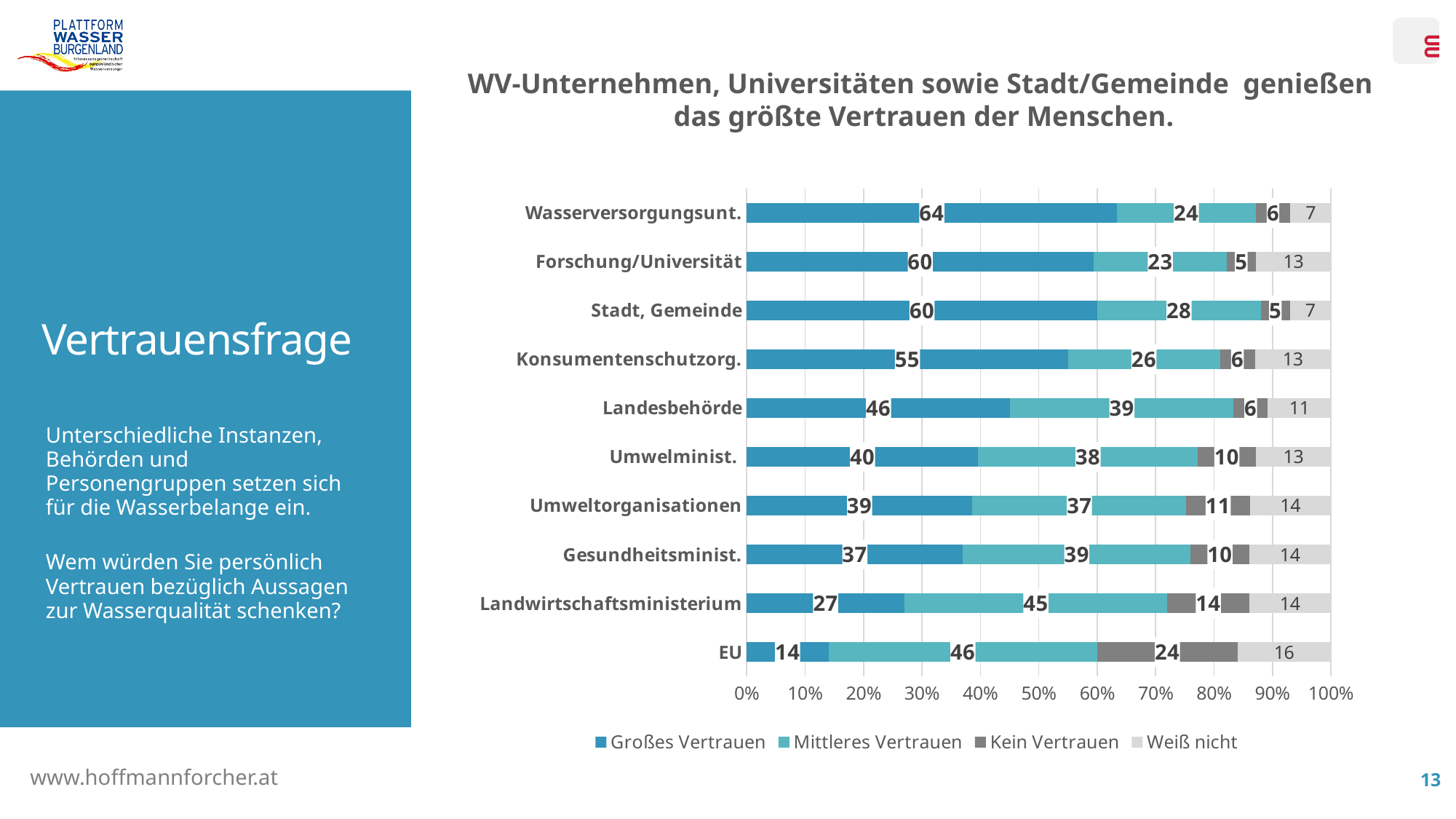
What is the value of 'Mittleres Vertrauen' for Landwirtschaftsministerium? 45 Which category has the highest value for 'Großes Vertrauen'? Wasserversorgungsunt. What is the value of 'Großes Vertrauen' for Wasserversorgungsunt.? 64 How many series does the legend list? 4 What is the value of 'Weiß nicht' for Forschung/Universität? 13 Which category has the lowest value for 'Großes Vertrauen'? EU What is the value of 'Kein Vertrauen' for EU? 24 Which series is shown in the lightest grey colour in the legend? Weiß nicht What is the difference between the 'Großes Vertrauen' values for Wasserversorgungsunt. and EU? 50 How many categories are plotted on the chart? 10 Which is larger: the 'Mittleres Vertrauen' value for Landesbehörde or for Stadt, Gemeinde? Landesbehörde What kind of chart is shown on the slide? stacked bar chart